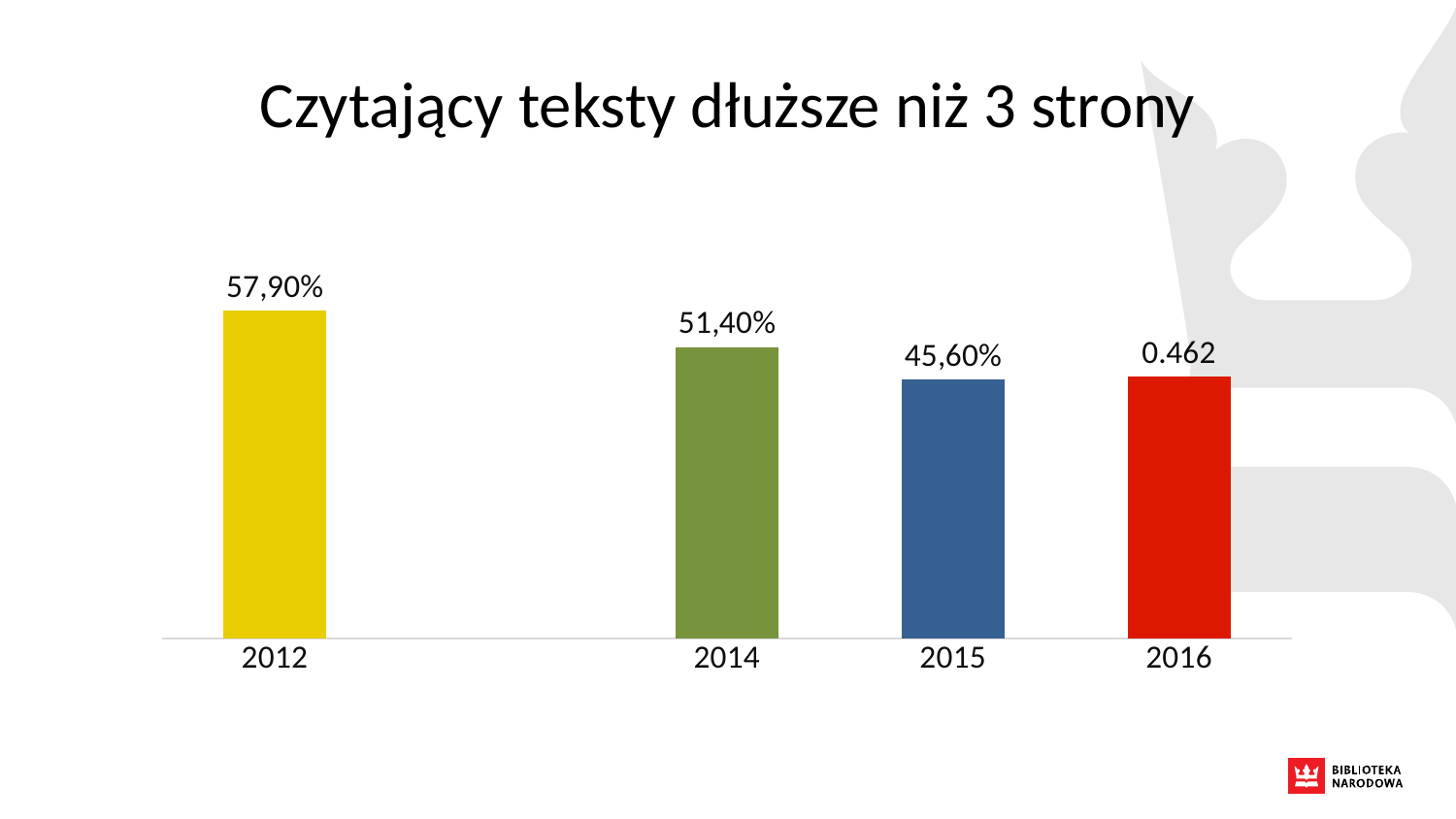
What is the difference between the values for 2012 and 2014? 6,50% What is the difference between the values for 2012 and 2015? 12,30% What value is shown for 2012? 57,90% What value is shown for 2014? 51,40% Which year has the highest value? 2012 What kind of chart is shown on the slide? Bar chart Do the values rise or fall from 2012 to 2015? Fall How many years are shown on the x axis? 4 Which is larger, the value for 2014 or the value for 2015? 2014 What is the data label shown above the 2016 bar? 0.462 Which year has the lowest value? 2015 What value is shown for 2015? 45,60%